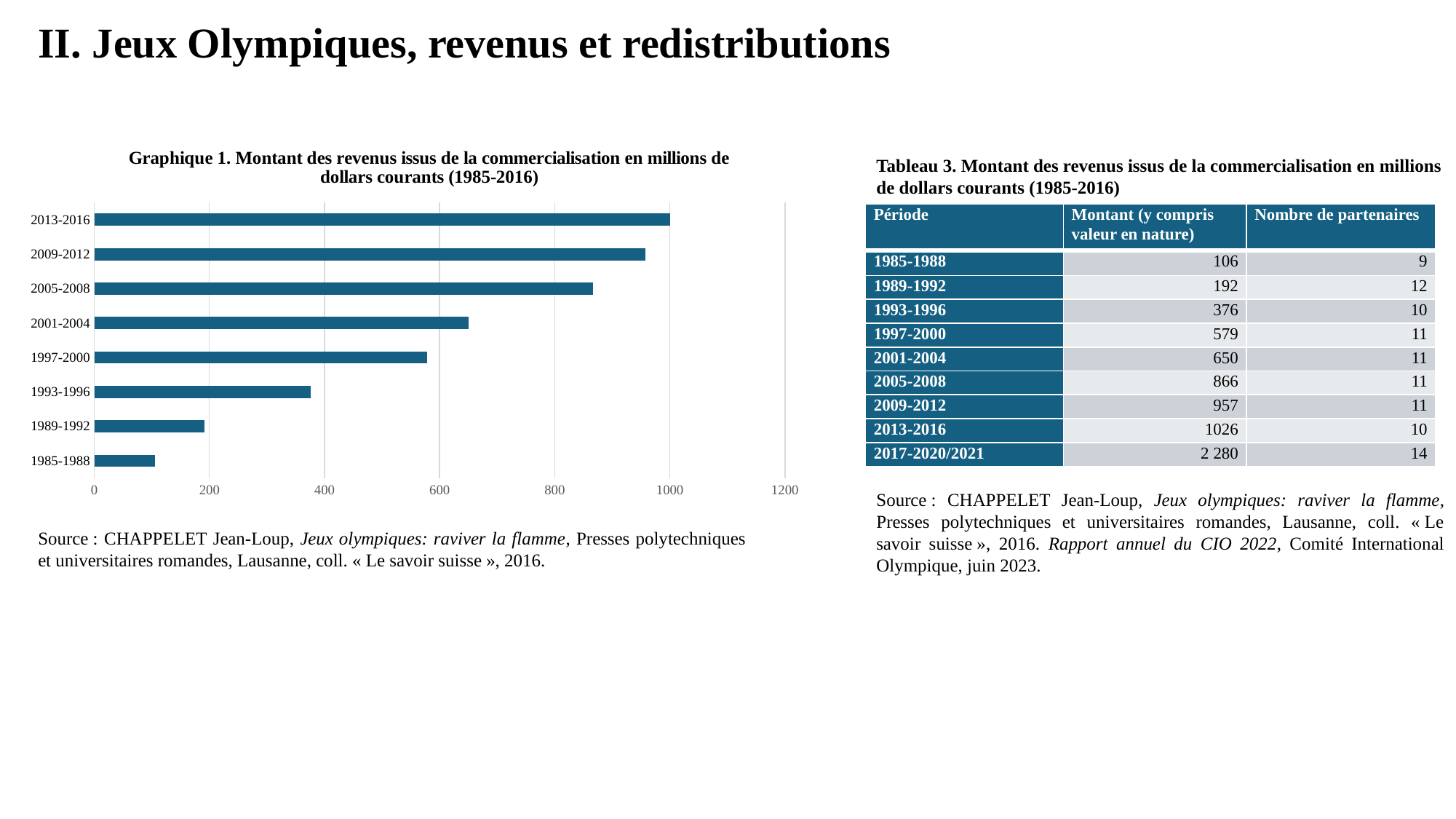
In Graphique 1, is the value for 1989-1992 greater or less than 400? less In Graphique 1, is the value for 2001-2004 greater or less than 600? greater In Graphique 1, is the value for 2009-2012 greater or less than 1000? less What kind of chart is Graphique 1? bar chart In Graphique 1, which is larger, the value for 2005-2008 or the value for 2001-2004? 2005-2008 How many periods are shown in Graphique 1? 8 In Graphique 1, which period has the lowest revenue? 1985-1988 What is the title of the chart on the slide? Graphique 1. Montant des revenus issus de la commercialisation en millions de dollars courants (1985-2016) In Graphique 1, which period has the highest revenue? 2013-2016 In Graphique 1, do the revenues rise or fall from 1985-1988 to 2013-2016? rise